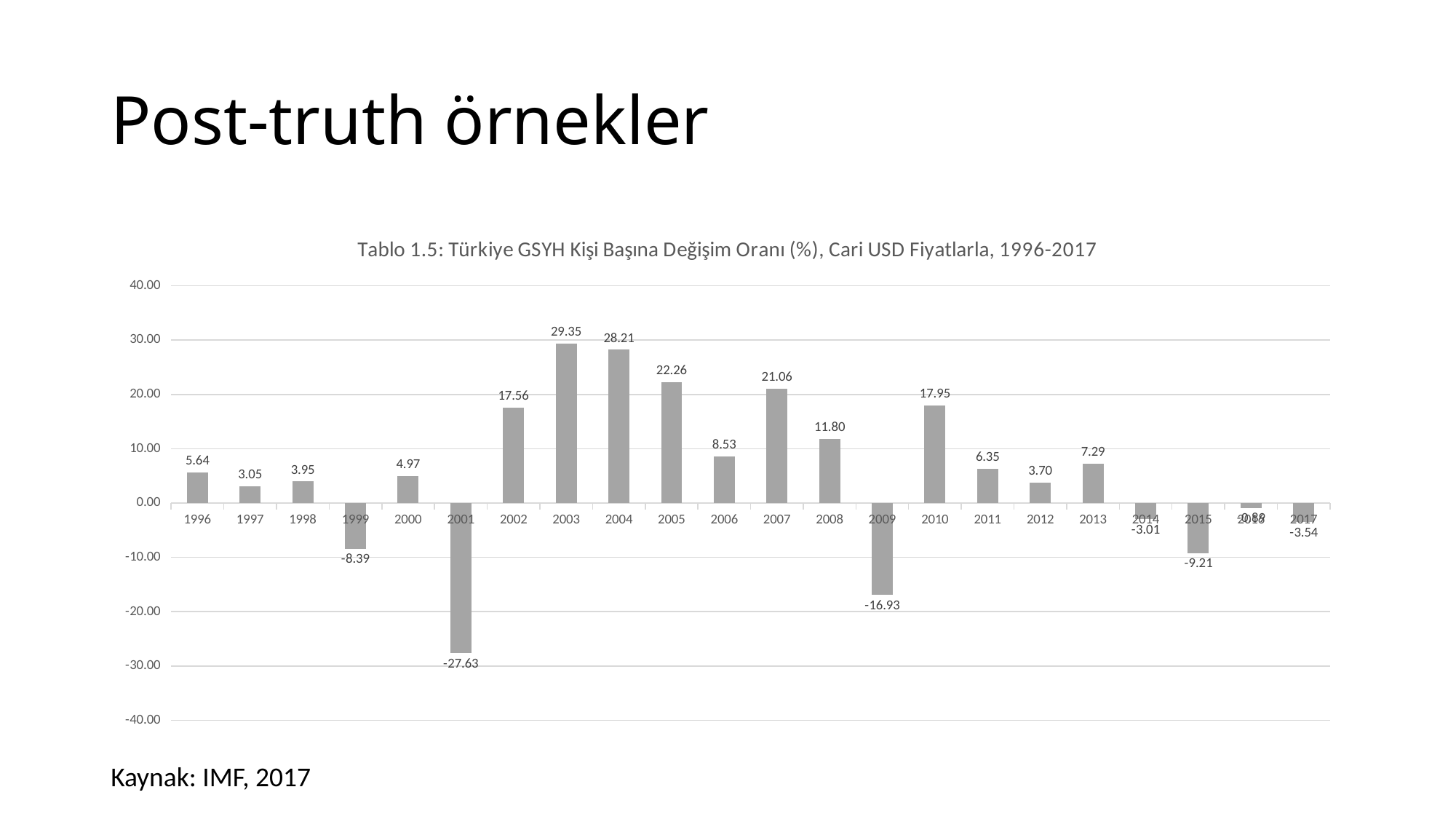
What is the difference between the values for 2003 and 2004? 1.14 What is the value for 2001? -27.63 Which is larger, the value for 2005 or the value for 2007? 2005 Is the value for 2002 greater or less than 10.00? greater Which year has the highest value? 2003 How many years are shown on the x axis? 22 Which year has the lowest value? 2001 What type of chart is shown on the slide? bar chart What is the value for 2003? 29.35 What is the value for 2009? -16.93 What is the value for 2010? 17.95 What is the title of the chart? Tablo 1.5: Türkiye GSYH Kişi Başına Değişim Oranı (%), Cari USD Fiyatlarla, 1996-2017